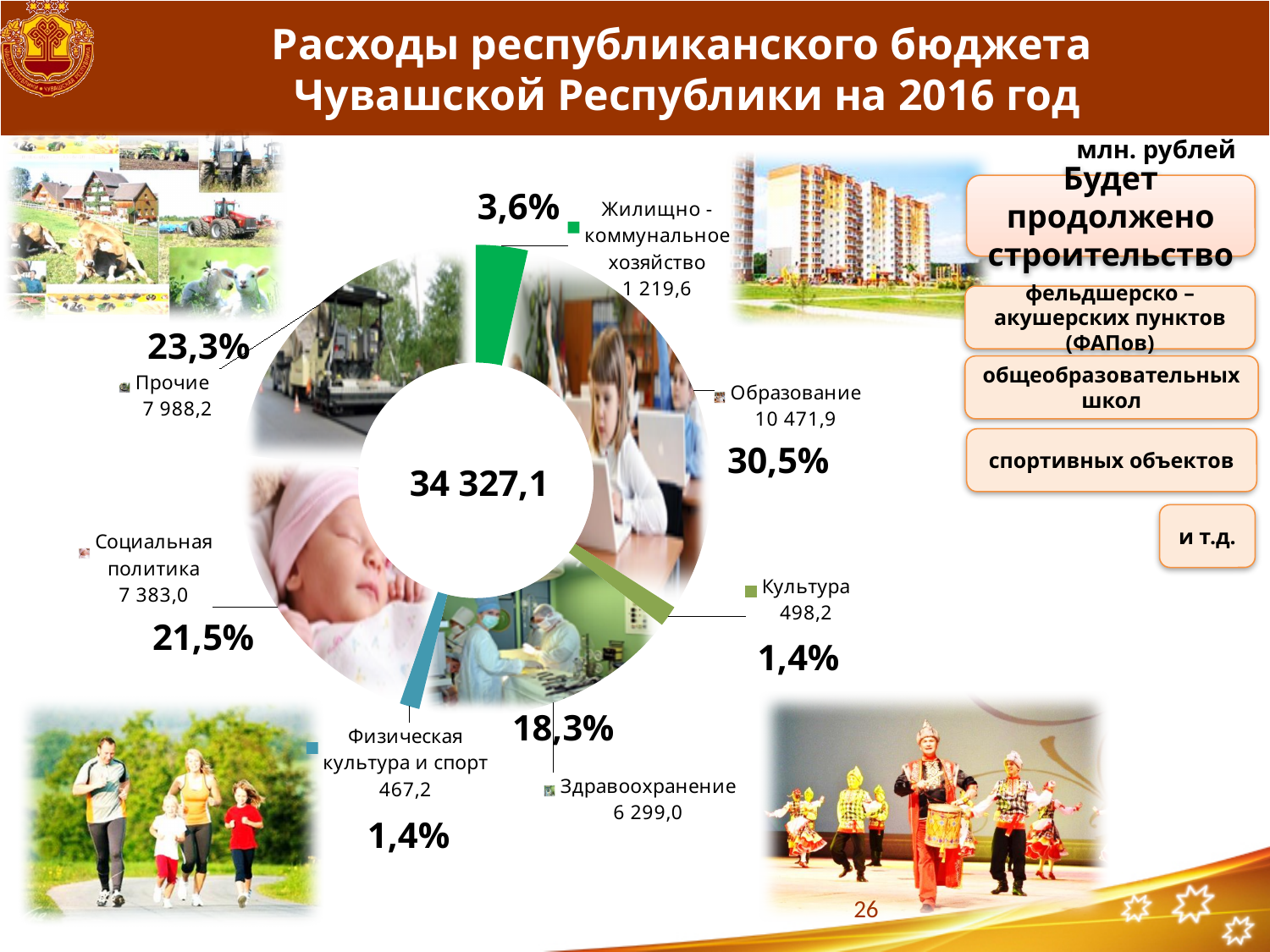
Which category has the lowest value? Физическая культура и спорт What is the difference between the values for Образование and Здравоохранение? 4 172,9 What is the value for Образование? 10 471,9 Which category has the highest value? Образование What is the value for Физическая культура и спорт? 467,2 How many categories does the pie chart show? 7 What kind of chart is shown on the slide? Pie (doughnut) chart What is the value for Социальная политика? 7 383,0 Which is larger, the value for Социальная политика or the value for Здравоохранение? Социальная политика What is the value for Здравоохранение? 6 299,0 What share of the pie does Образование represent? 30,5% What share of the pie does Прочие represent? 23,3%